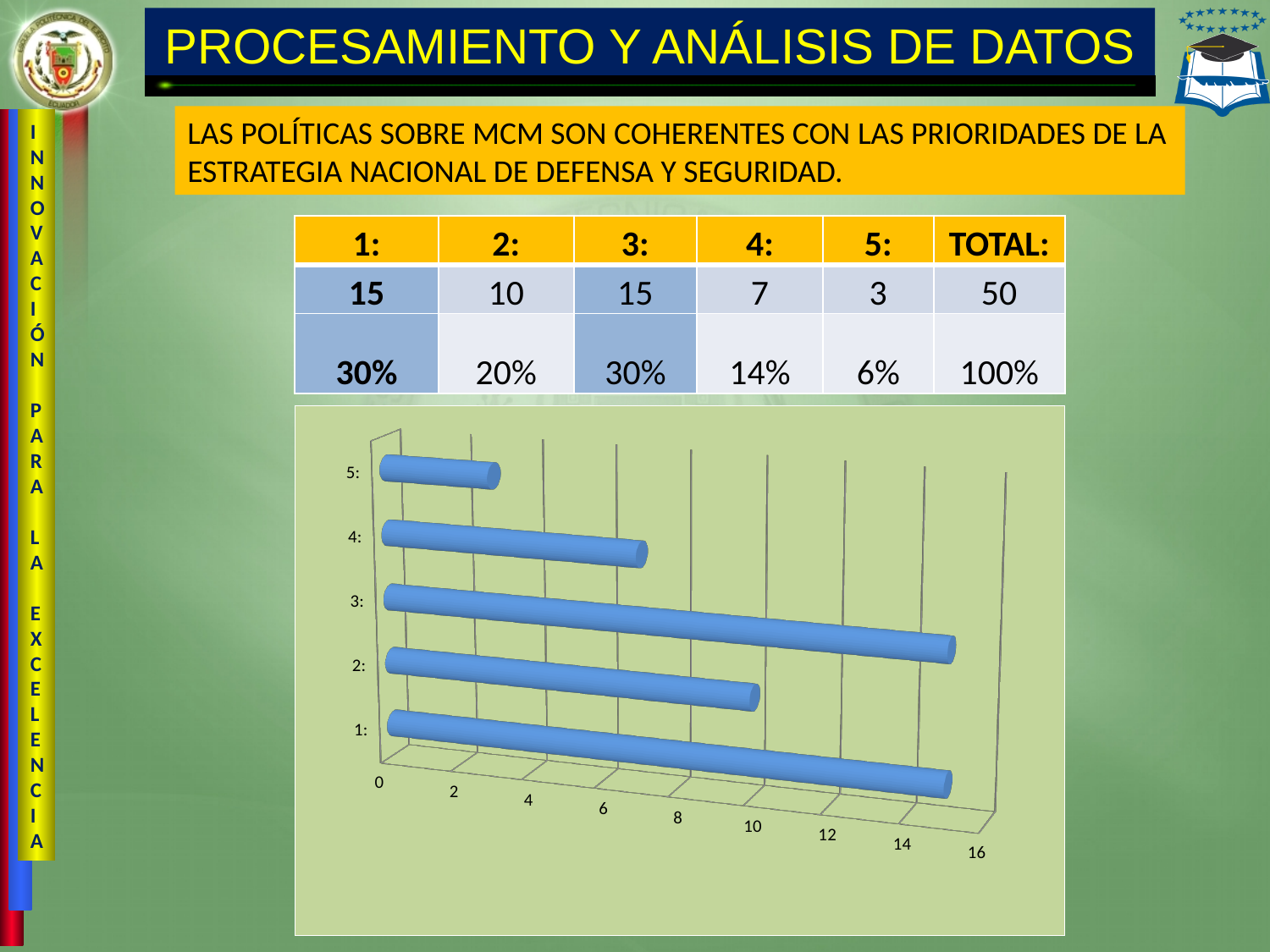
Is the value for category 5: greater or less than 4? less Which is larger in the chart, the value for category 4: or the value for category 5:? 4: Is the value for category 3: greater or less than 14? greater What kind of chart is shown on the slide? bar chart Which is larger in the chart, the value for category 2: or the value for category 4:? 2: What is the highest value shown on the chart's value axis? 16 Which category has the shortest bar in the chart? 5: Is the value for category 4: greater or less than 6? greater Which is larger in the chart, the value for category 3: or the value for category 2:? 3: How many categories does the bar chart show? 5